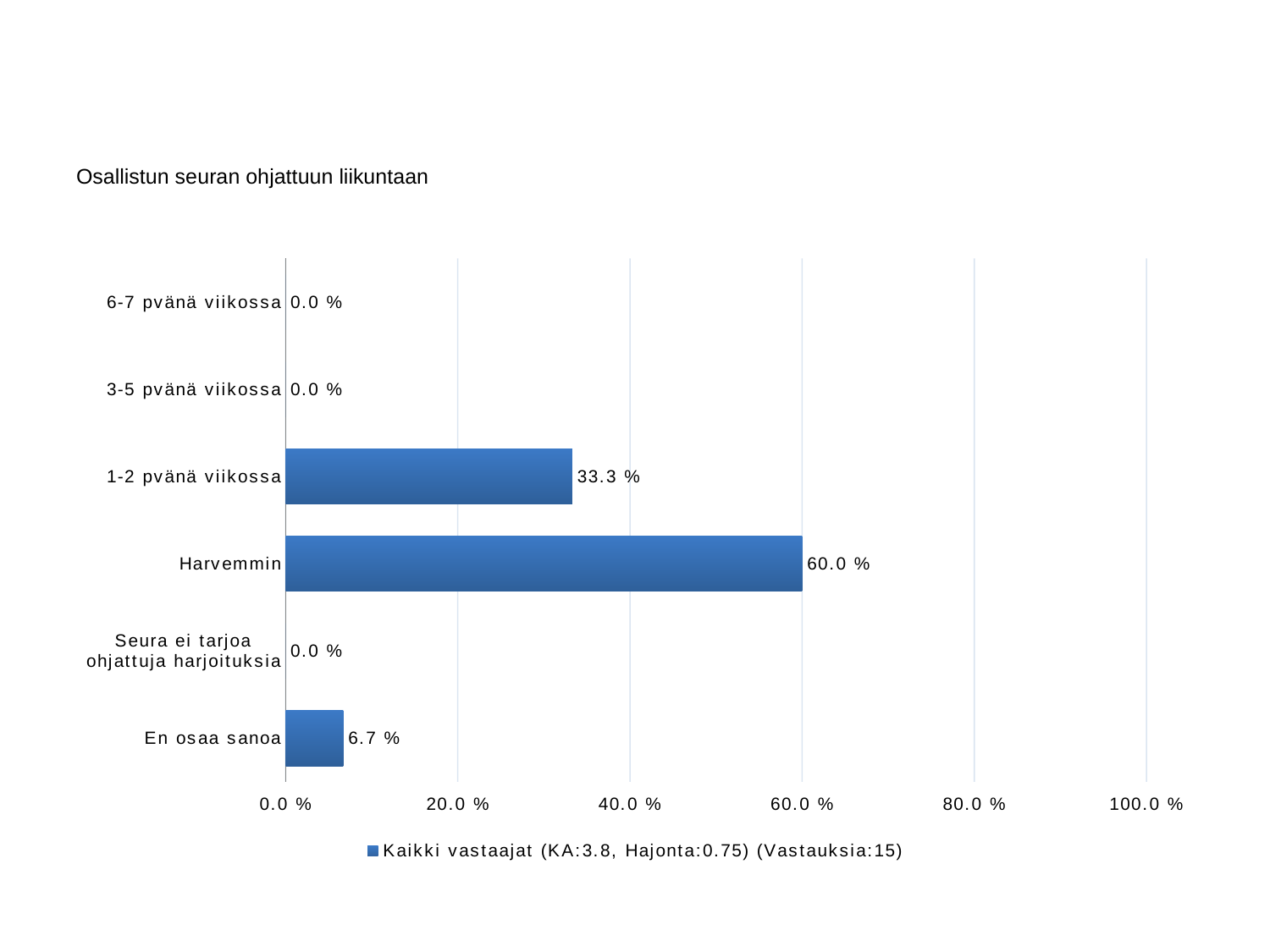
What is the value for En osaa sanoa? 6.7 % What is the value for 3-5 pvänä viikossa? 0.0 % Which category has the highest value? Harvemmin Which is larger, the value for 1-2 pvänä viikossa or the value for En osaa sanoa? 1-2 pvänä viikossa What is the value for 1-2 pvänä viikossa? 33.3 % How many series does the legend list? 1 How many categories are shown on the chart? 6 Is the value for Harvemmin greater or less than 40.0 %? greater What is the difference between the values for Harvemmin and 1-2 pvänä viikossa? 26.7 % What is the title of the chart? Osallistun seuran ohjattuun liikuntaan What kind of chart is shown on the slide? bar chart What is the value for Harvemmin? 60.0 %